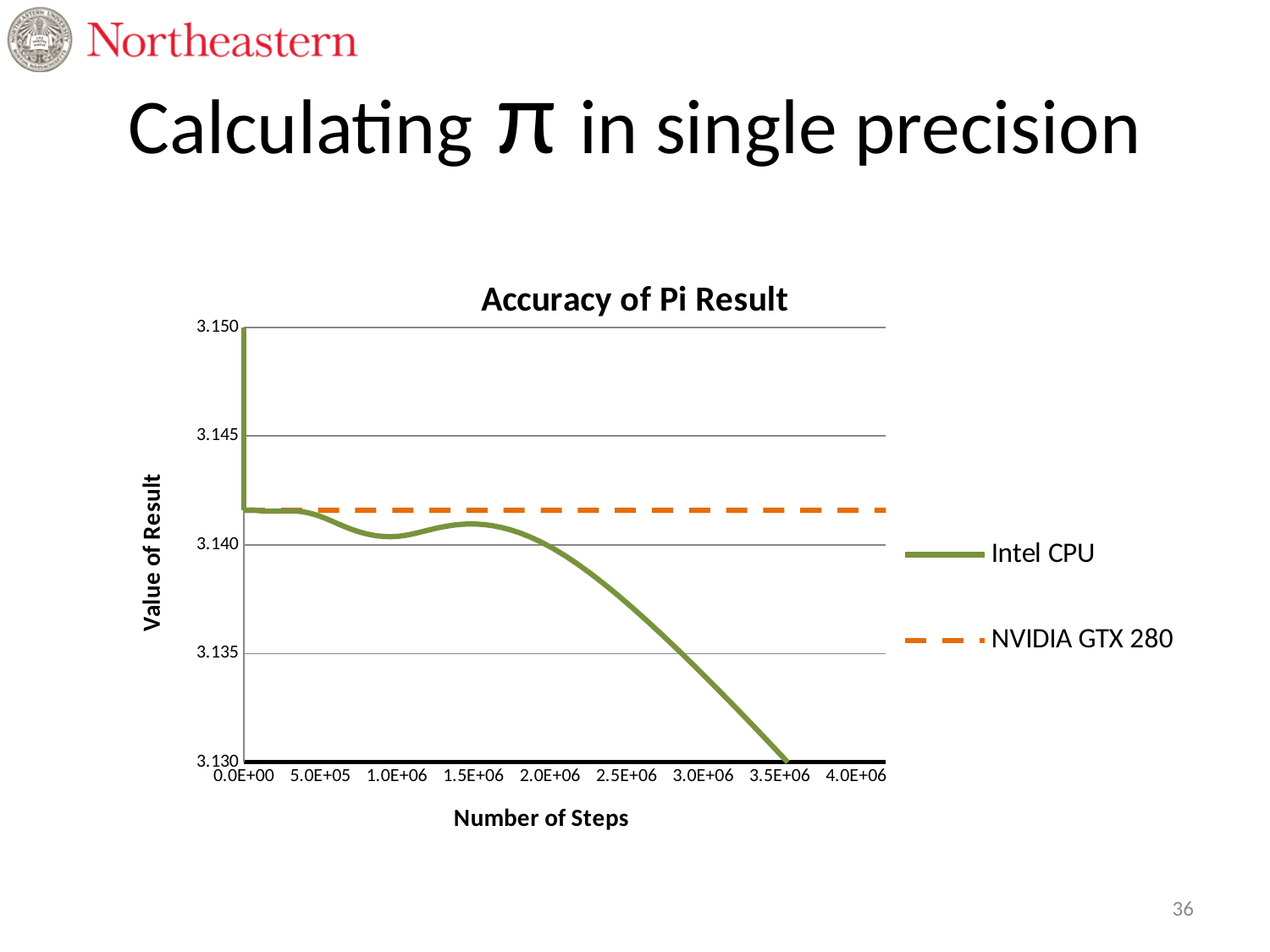
What is the title of the chart? Accuracy of Pi Result What is the label of the x axis of the chart? Number of Steps Is the value of the NVIDIA GTX 280 series greater or less than 3.140? greater Does the Intel CPU series rise or fall as the number of steps increases beyond 1.5E+06? Fall Which series stays roughly constant across the number of steps? NVIDIA GTX 280 Is the value of the Intel CPU series at 2.5E+06 steps greater or less than 3.140? less Is the value of the NVIDIA GTX 280 series greater or less than 3.145? less At 3.0E+06 steps, which series has the higher value, Intel CPU or NVIDIA GTX 280? NVIDIA GTX 280 What kind of chart is shown on the slide? Line chart How many series does the legend of the chart list? 2